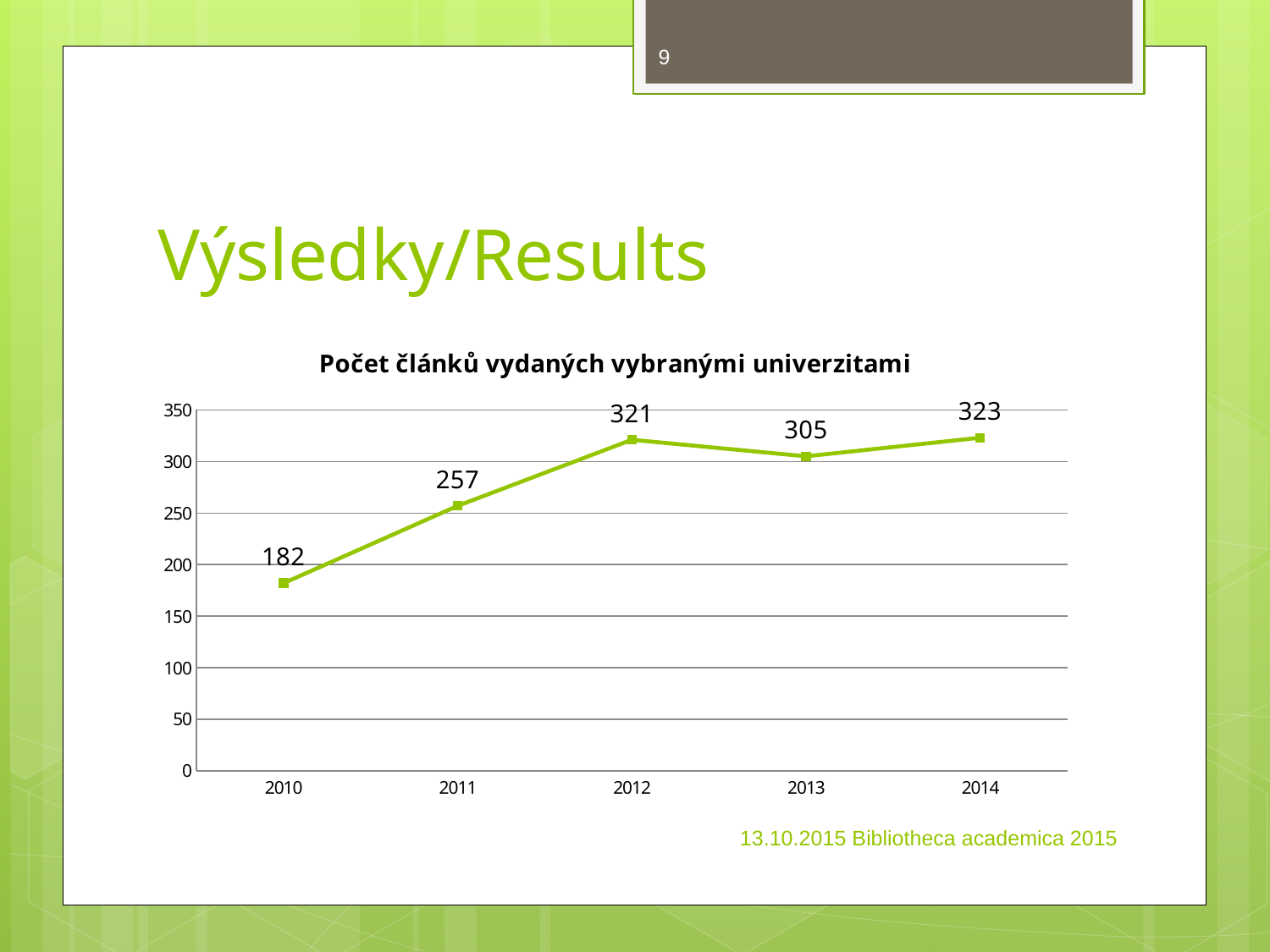
What is the difference between the values for 2012 and 2013? 16 How many years are plotted on the chart? 5 Is the value for 2011 greater or less than 250? greater What is the value for 2013? 305 What is the title of the chart? Počet článků vydaných vybranými univerzitami What is the value for 2010? 182 What kind of chart is shown on the slide? line chart Which year has the lowest value? 2010 Which is larger, the value for 2012 or the value for 2013? 2012 What is the difference between the values for 2011 and 2010? 75 Which year has the highest value? 2014 What is the value for 2011? 257